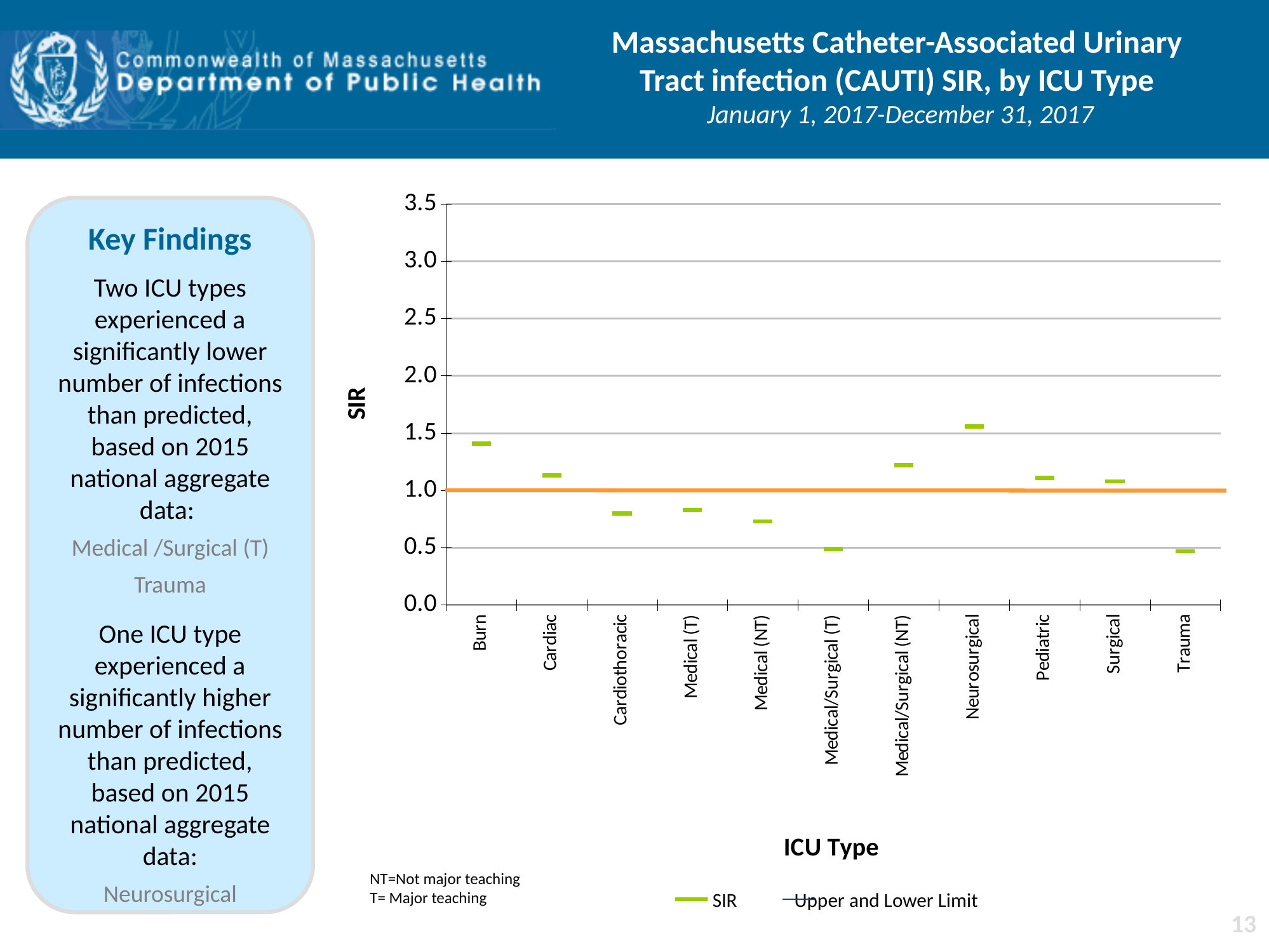
Is the SIR value for Burn greater or less than 1.0? greater Which ICU type has the highest SIR value on the chart? Neurosurgical Is the SIR value for Medical (NT) greater or less than 1.0? less Which has the larger SIR value, Burn or Cardiac? Burn Is the SIR value for Trauma greater or less than 1.0? less How many series does the chart legend list? 2 Which has the larger SIR value, Medical/Surgical (NT) or Medical/Surgical (T)? Medical/Surgical (NT) What is the label of the y axis of the chart? SIR How many ICU types are shown on the x axis of the chart? 11